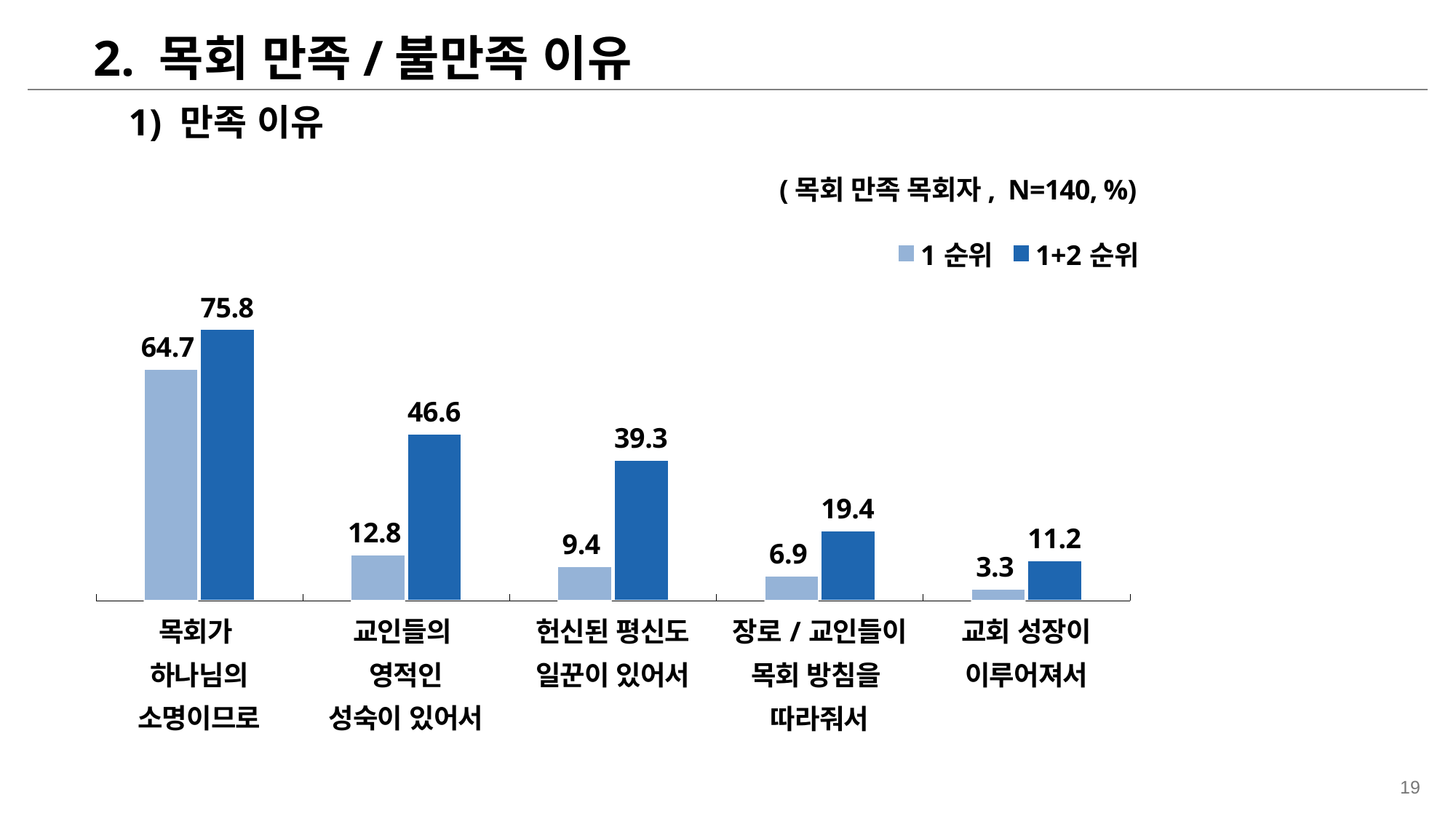
Which is larger: the '1+2 순위' value for '장로 / 교인들이 목회 방침을 따라줘서' or the '1+2 순위' value for '교회 성장이 이루어져서'? 장로 / 교인들이 목회 방침을 따라줘서 What is the sample size (N) stated above the chart? N=140 How many categories are shown on the x axis? 5 What is the '1+2 순위' value for '헌신된 평신도 일꾼이 있어서'? 39.3 What kind of chart is shown on the slide? Bar chart Which category has the highest '1+2 순위' value? 목회가 하나님의 소명이므로 What is the '1 순위' value for '교회 성장이 이루어져서'? 3.3 How many series does the legend list? 2 What is the '1 순위' value for '교인들의 영적인 성숙이 있어서'? 12.8 What is the difference between the '1+2 순위' and '1 순위' values for '교인들의 영적인 성숙이 있어서'? 33.8 What is the '1+2 순위' value for '목회가 하나님의 소명이므로'? 75.8 Which category has the lowest '1 순위' value? 교회 성장이 이루어져서